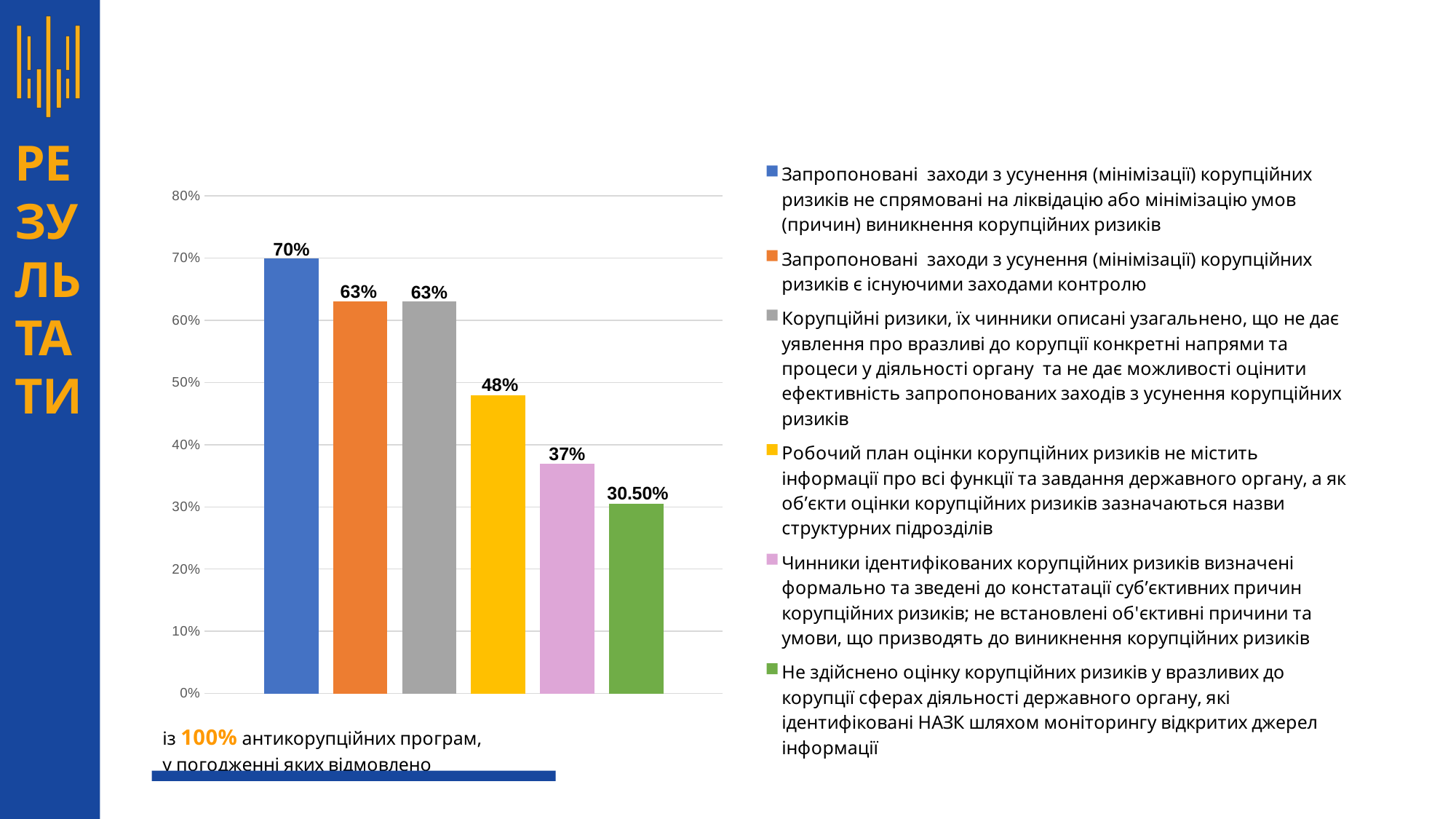
What is the value of the bar for "Не здійснено оцінку корупційних ризиків у вразливих до корупції сферах діяльності державного органу..."? 30.50% Which legend entry has the lowest value in the chart? Не здійснено оцінку корупційних ризиків у вразливих до корупції сферах діяльності державного органу, які ідентифіковані НАЗК шляхом моніторингу відкритих джерел інформації What type of chart is shown on the slide? bar chart What is the value of the bar for "Запропоновані заходи з усунення (мінімізації) корупційних ризиків є існуючими заходами контролю"? 63% How many bars are plotted in the chart? 6 What is the value of the bar for "Запропоновані заходи з усунення (мінімізації) корупційних ризиків не спрямовані на ліквідацію або мінімізацію умов (причин) виникнення корупційних ризиків"? 70% What is the value of the bar for "Робочий план оцінки корупційних ризиків не містить інформації про всі функції та завдання державного органу..."? 48% Which is larger: the value for "Робочий план оцінки корупційних ризиків не містить інформації..." or the value for "Чинники ідентифікованих корупційних ризиків визначені формально..."? Робочий план оцінки корупційних ризиків не містить інформації... Which legend entry has the highest value in the chart? Запропоновані заходи з усунення (мінімізації) корупційних ризиків не спрямовані на ліквідацію або мінімізацію умов (причин) виникнення корупційних ризиків What is the difference between the highest bar (70%) and the lowest bar (30.50%)? 39.50% Do the bar values rise or fall from left to right across the chart? fall How many entries does the chart legend list? 6